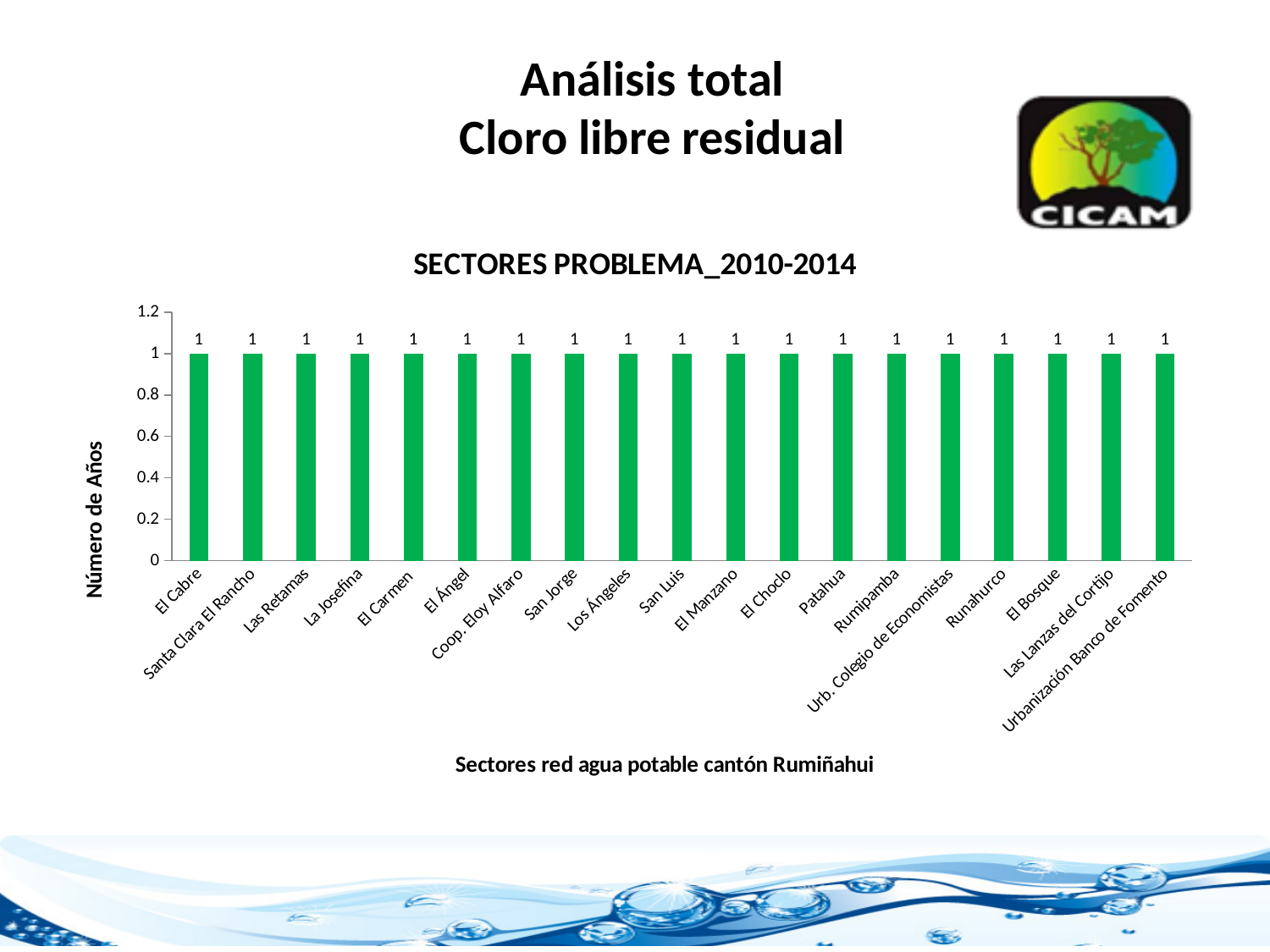
What is the difference between the values for San Luis and El Bosque? 0 Do the values rise, fall, or stay the same across the sectors along the x axis? stay the same Is the value for Las Retamas greater or less than 0.8? greater How many sectors (categories) are plotted on the chart? 19 What is the value for Urbanización Banco de Fomento? 1 What is the value for El Cabre? 1 Is the value for Patahua greater or less than 1.2? less What type of chart is shown on the slide? bar chart What is the label of the vertical axis? Número de Años What is the title of the chart? SECTORES PROBLEMA_2010-2014 What is the value for Coop. Eloy Alfaro? 1 What is the value for Rumipamba? 1